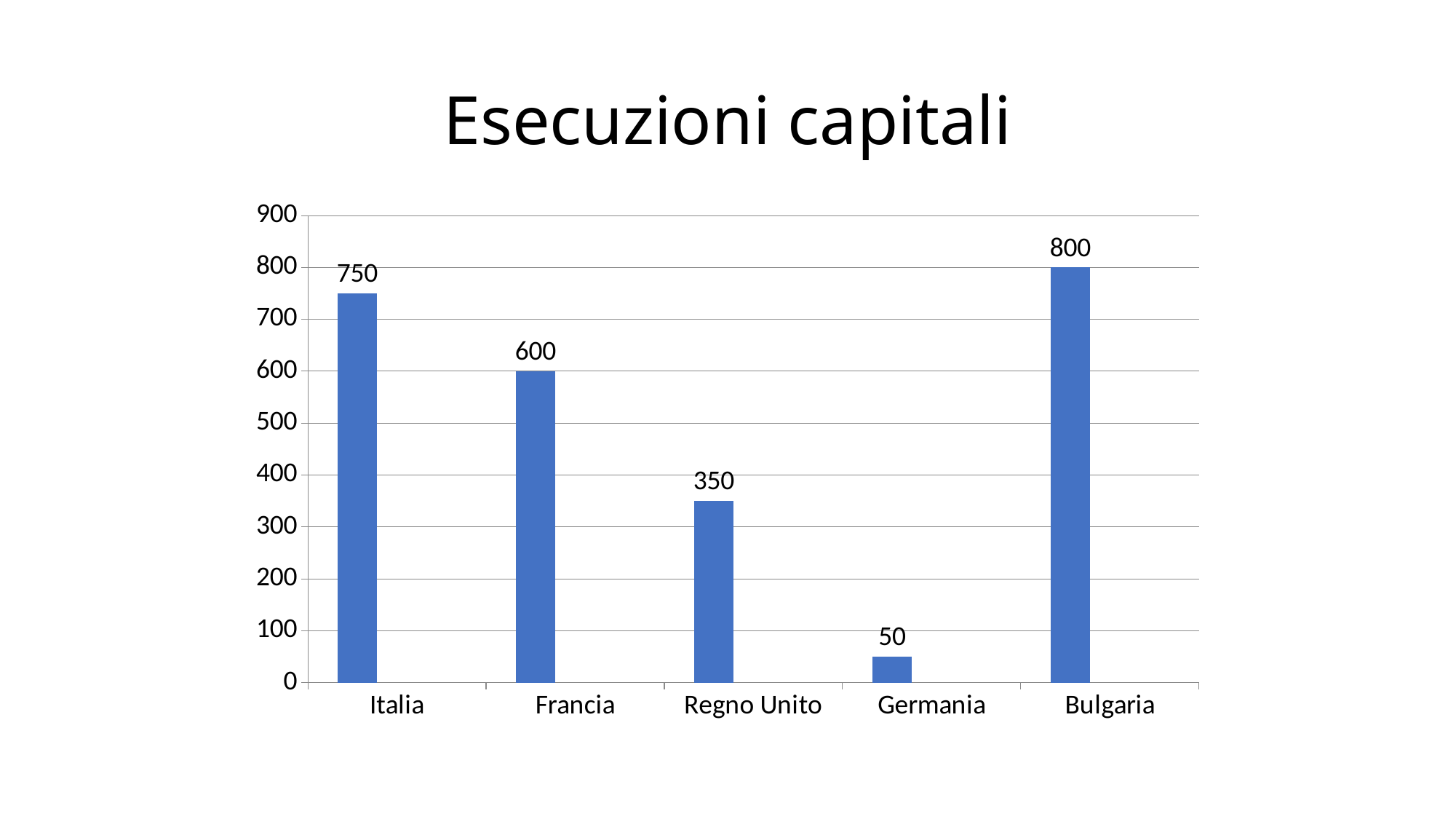
What is the value for Regno Unito? 350 What is the value for Italia? 750 What kind of chart is shown on the slide? bar chart What is the difference between the values for Italia and Regno Unito? 400 What is the title of the chart? Esecuzioni capitali Which category has the highest value? Bulgaria How many categories are shown on the x axis? 5 Which is larger, the value for Francia or the value for Regno Unito? Francia What is the difference between the values for Bulgaria and Francia? 200 Which category has the lowest value? Germania Is the value for Francia greater or less than 500? greater What is the value for Germania? 50